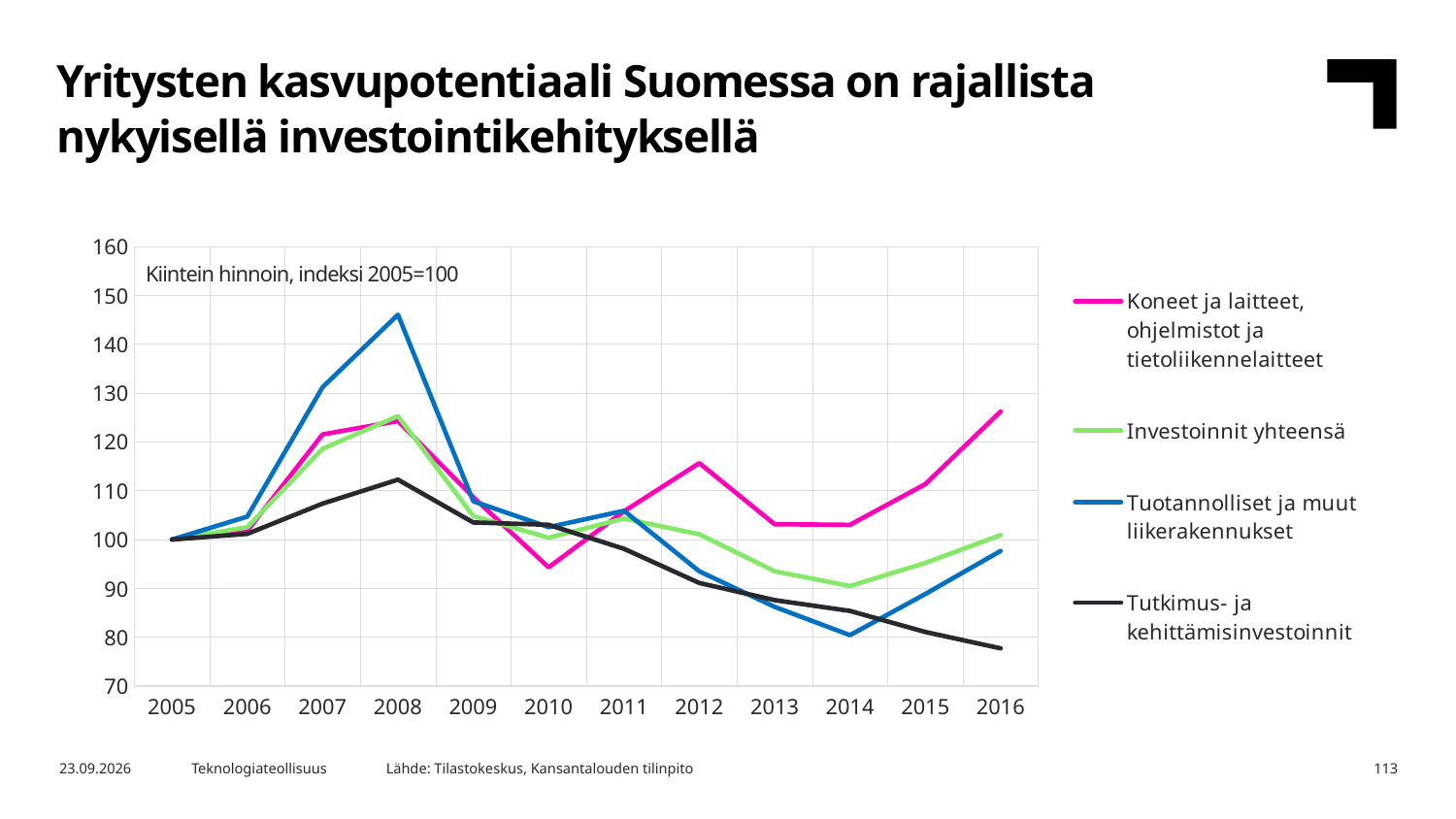
Is the value for Koneet ja laitteet, ohjelmistot ja tietoliikennelaitteet in 2016 greater or less than 120? greater In 2016, which series has the higher value: Koneet ja laitteet, ohjelmistot ja tietoliikennelaitteet or Investoinnit yhteensä? Koneet ja laitteet, ohjelmistot ja tietoliikennelaitteet Is the value for Tutkimus- ja kehittämisinvestoinnit in 2016 greater or less than 80? less In which year does the Tutkimus- ja kehittämisinvestoinnit series reach its lowest value? 2016 Does the Tutkimus- ja kehittämisinvestoinnit series rise or fall from 2008 to 2016? fall What kind of chart is shown on the slide? line chart How many series does the legend list? 4 What is the index value of all series in 2005? 100 Is the value for Tuotannolliset ja muut liikerakennukset in 2008 greater or less than 140? greater In which year does the Tuotannolliset ja muut liikerakennukset series reach its highest value? 2008 How many years are shown on the x axis? 12 What base year and index value does the chart note state? indeksi 2005=100